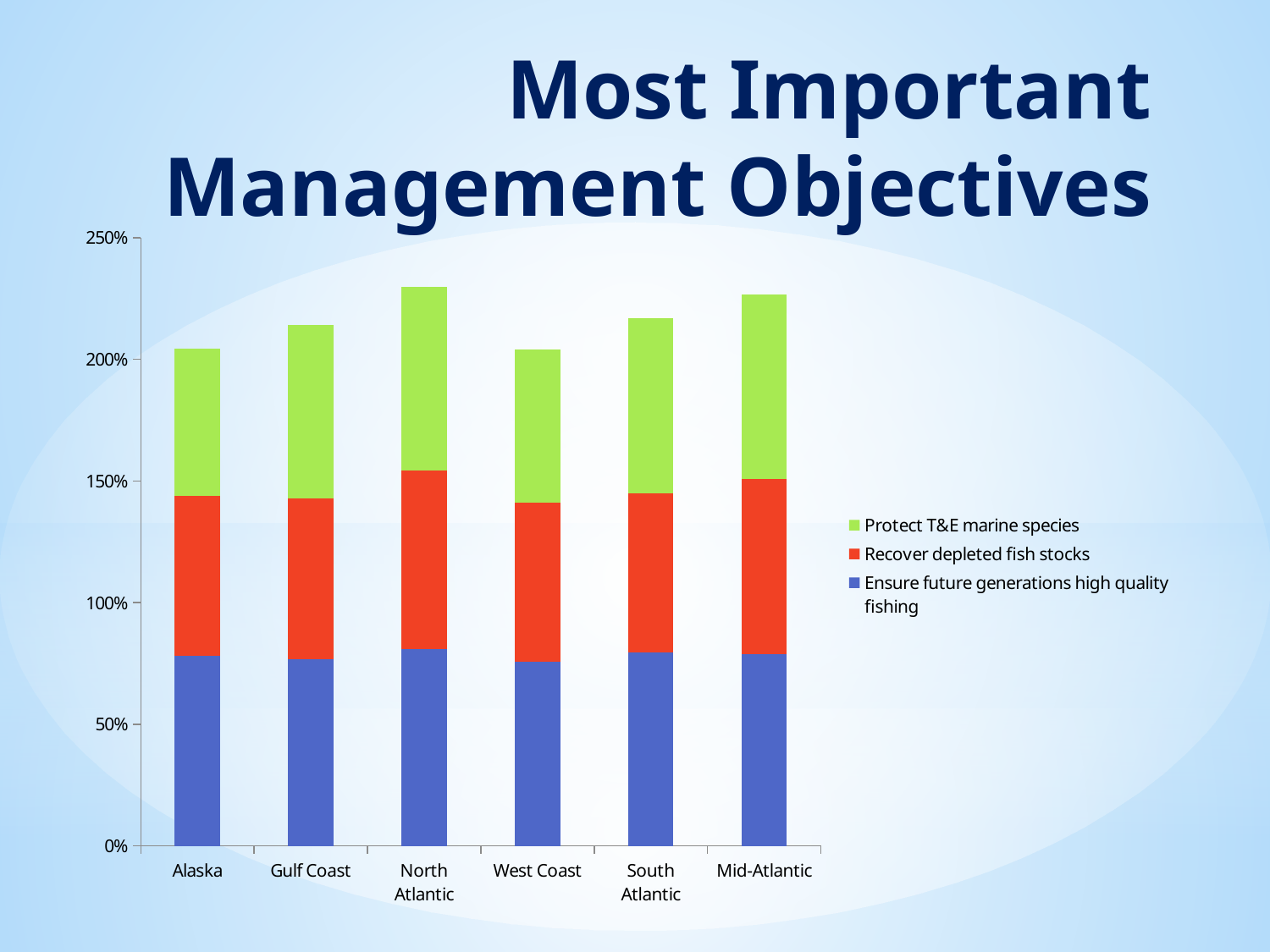
What is the title of the chart on the slide? Most Important Management Objectives How many regions are shown on the x axis of the chart? 6 Which has the larger total stacked value, Gulf Coast or Alaska? Gulf Coast How many series does the chart's legend list? 3 Is the total stacked value for Mid-Atlantic greater or less than 250%? less Is the total stacked value for Alaska greater or less than 200%? greater What kind of chart is shown on the slide? Stacked bar chart Which has the larger total stacked value, North Atlantic or West Coast? North Atlantic Which series is shown in green in the chart? Protect T&E marine species Is the value for 'Ensure future generations high quality fishing' for North Atlantic greater or less than 50%? greater Which region has the tallest stacked bar overall? North Atlantic